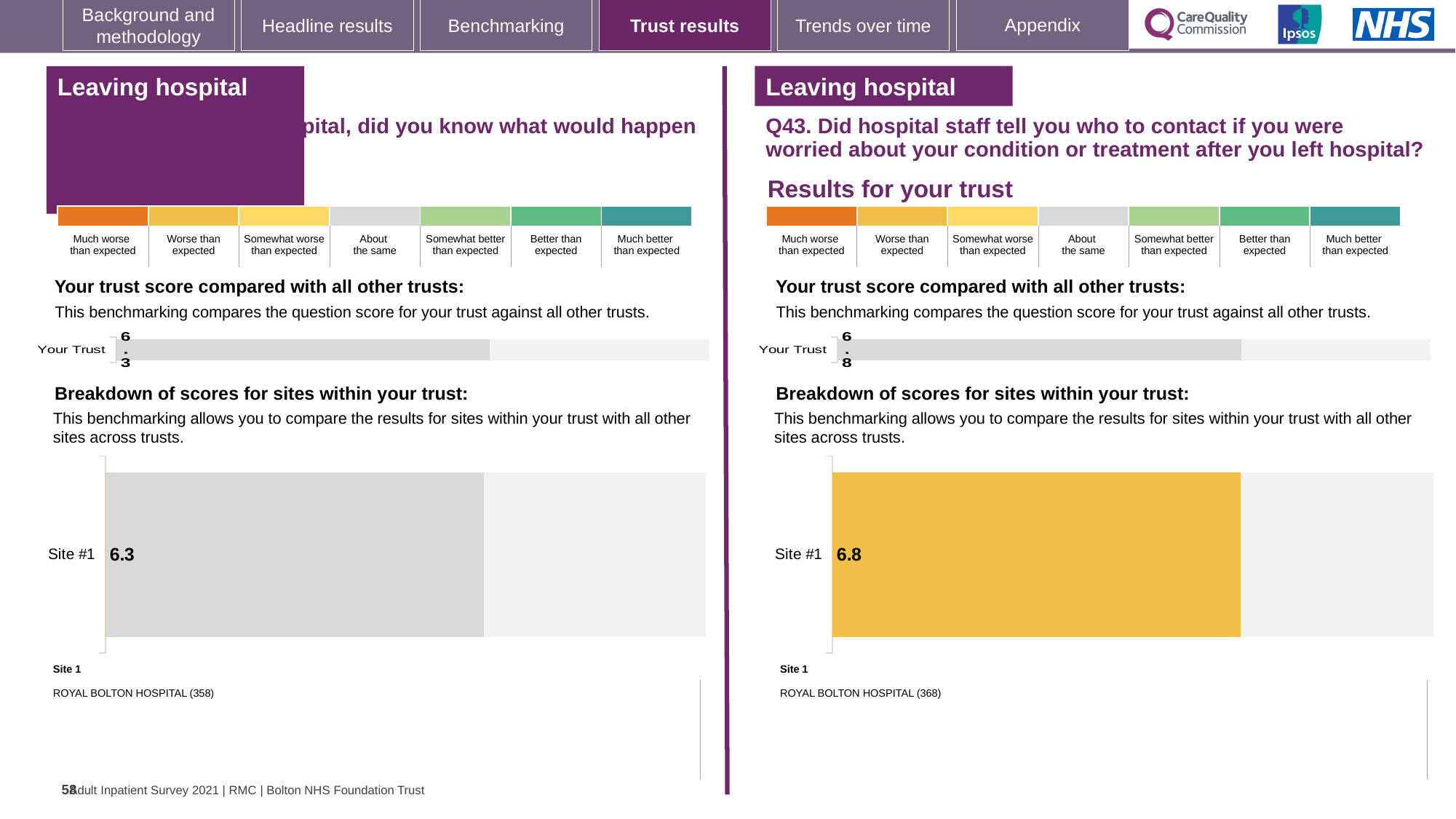
On the right half of the slide (Q43), what is the value shown for 'Your Trust' in the trust score comparison chart? 6.8 Which Site #1 score is larger: the one on the left half of the slide or the one on the right half (Q43)? The right half (Q43), 6.8 What type of chart is used to show the breakdown of scores for sites within your trust on the right half of the slide (Q43)? Bar chart How many sites are shown in the breakdown of scores chart on the right half of the slide (Q43)? 1 On the left half of the slide, what is the score shown for Site #1 in the breakdown of scores for sites within your trust? 6.3 On the right half of the slide (Q43), what is the score shown for Site #1 in the breakdown of scores for sites within your trust? 6.8 What is the difference between the Site #1 score on the right half of the slide (Q43) and the Site #1 score on the left half? 0.5 On the left half of the slide, what is the value shown for 'Your Trust' in the trust score comparison chart? 6.3 On the left half of the slide, which site name is listed as Site 1 below the breakdown chart? ROYAL BOLTON HOSPITAL (358) On the right half of the slide (Q43), what colour is the Site #1 bar in the breakdown of scores chart? Yellow On the right half of the slide (Q43), which site name is listed as Site 1 below the breakdown chart? ROYAL BOLTON HOSPITAL (368) How many sites are shown in the breakdown of scores chart on the left half of the slide? 1